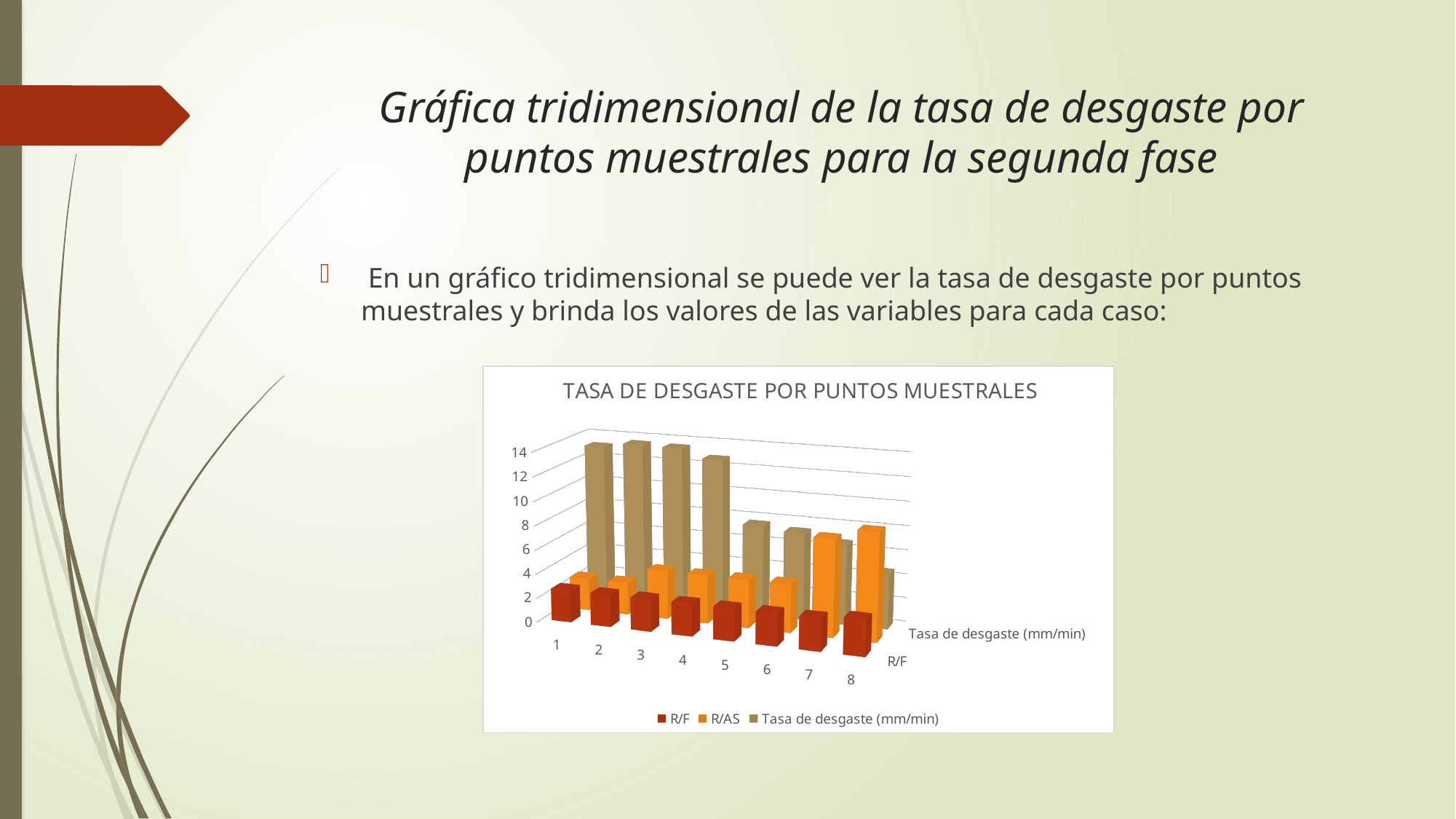
How many series does the legend list? 3 How many sample points (categories) are shown on the x axis? 8 Which is larger, the Tasa de desgaste (mm/min) value for point 1 or for point 5? point 1 Which series are listed in the legend? R/F, R/AS, Tasa de desgaste (mm/min) Is the R/AS value for point 8 greater or less than 4? greater What kind of chart is shown on the slide? bar chart Do the Tasa de desgaste (mm/min) values generally rise or fall from point 1 to point 8? fall What is the title of the chart? TASA DE DESGASTE POR PUNTOS MUESTRALES Is the Tasa de desgaste (mm/min) value for point 1 greater or less than 10? greater Is the R/F value for point 1 greater or less than 4? less Which sample point has the lowest Tasa de desgaste (mm/min) value? 8